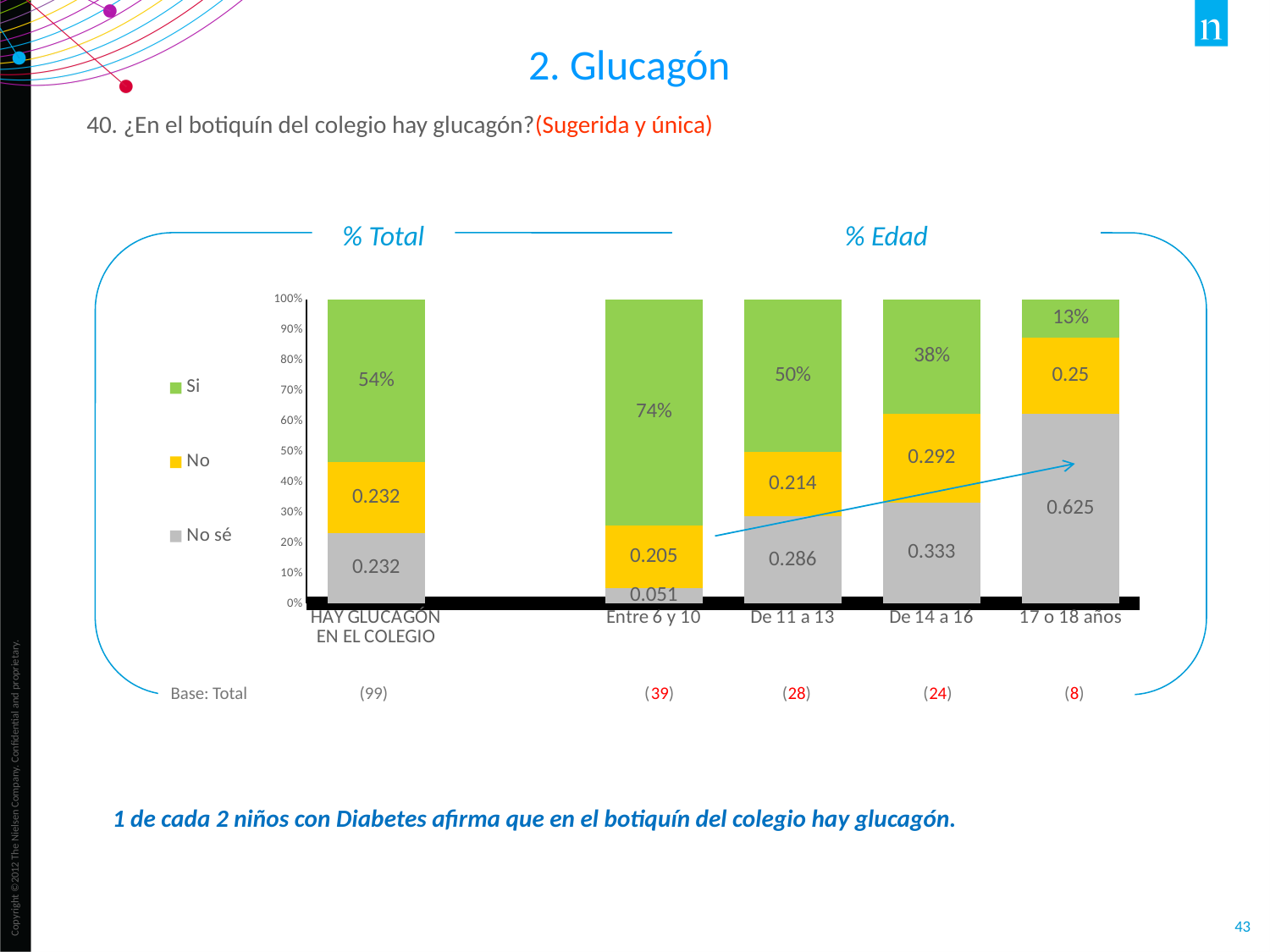
What is the 'Si' value for the 'Entre 6 y 10' bar? 74% Does the 'Si' value rise or fall across the age groups from 'Entre 6 y 10' to '17 o 18 años'? fall What is the 'No' value for the 'De 14 a 16' bar? 0.292 What is the 'No sé' value for the 'HAY GLUCAGÓN EN EL COLEGIO' bar? 0.232 Which series is shown in green in the legend? Si Which category has the lowest 'No sé' value? Entre 6 y 10 What kind of chart is shown on the slide? stacked bar chart How many bars are plotted in the chart? 5 How many series does the legend list? 3 Which is larger, the 'Si' value for 'De 11 a 13' or for 'De 14 a 16'? De 11 a 13 Which age group has the highest 'Si' value? Entre 6 y 10 What is the 'No sé' value for the '17 o 18 años' bar? 0.625